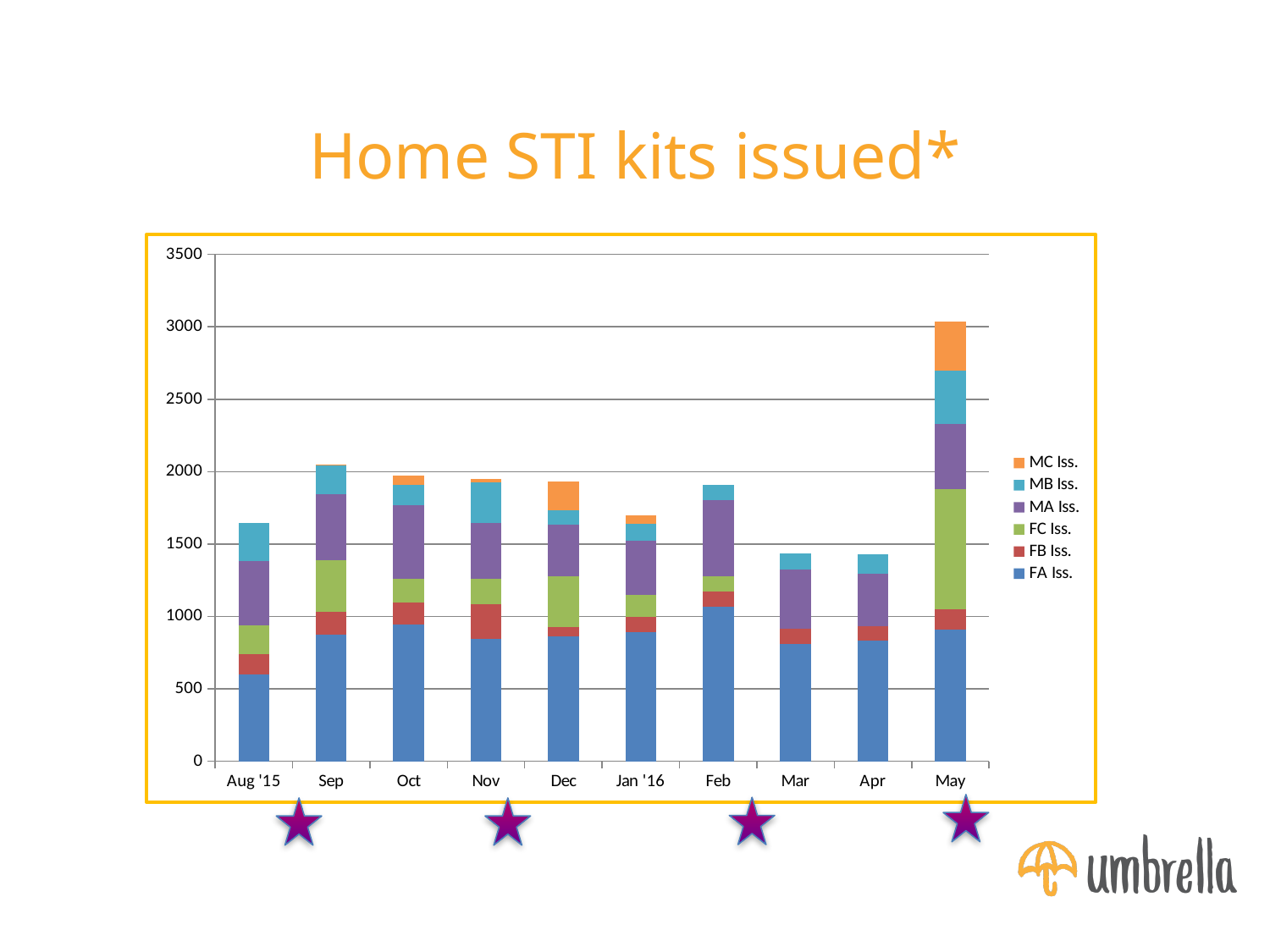
Is the FA Iss. value for Aug '15 greater or less than 1000? less Is the total for Mar greater or less than 1500? less How many series does the legend list? 6 Is the total for Aug '15 greater or less than 2000? less How many months are shown along the x axis of the chart? 10 What kind of chart is shown on the slide? Stacked bar chart Which month has the highest total of home STI kits issued? May Which series is listed first (at the top) in the legend? MC Iss. What is the title of the chart on the slide? Home STI kits issued* Which month has the larger total, May or Feb? May Which month has the larger total, Aug '15 or Sep? Sep